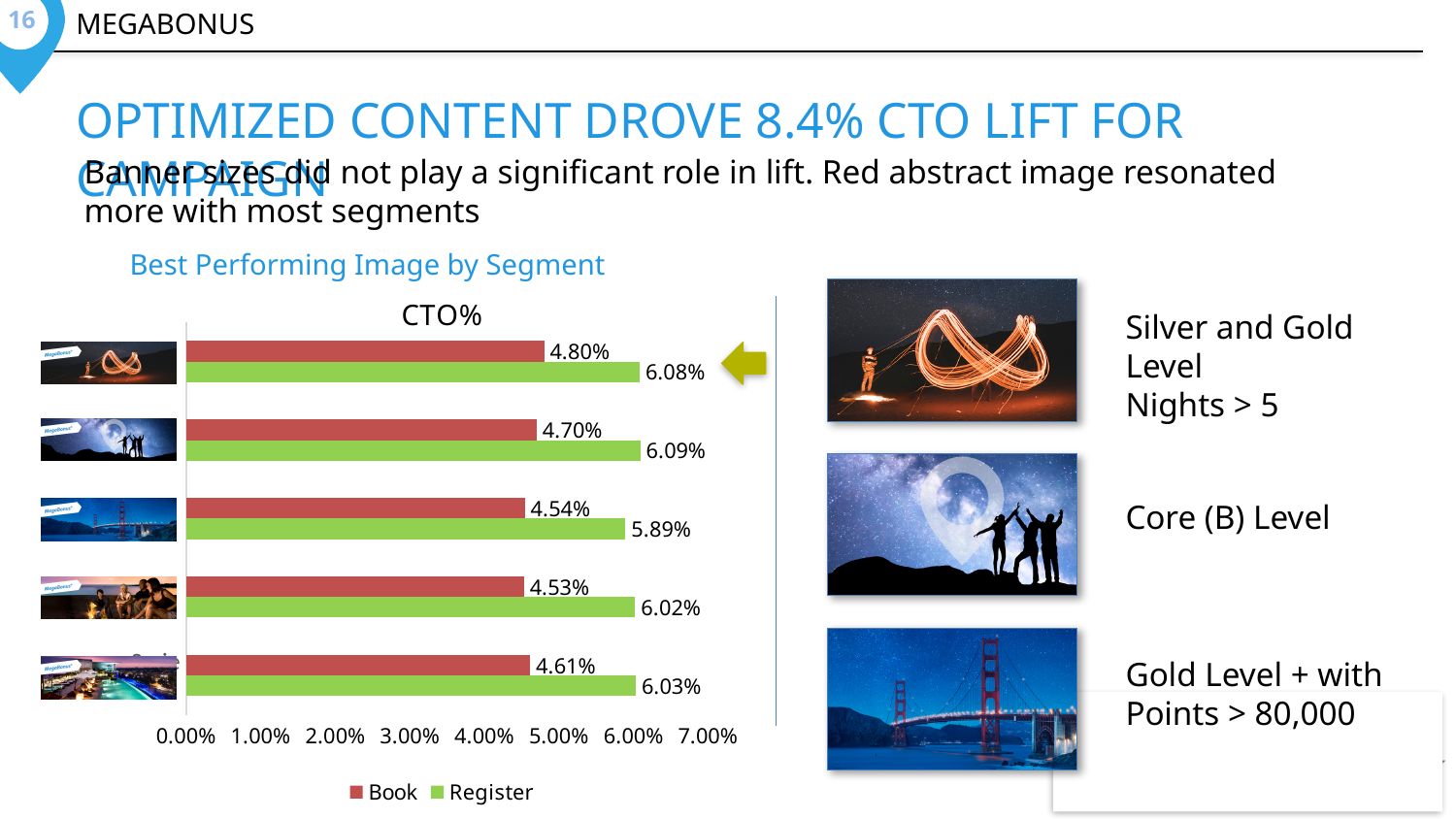
What is the Book value for the top category in the chart? 4.80% How many categories (image rows) are plotted in the chart? 5 What is the Book value for the bottom category in the chart? 4.61% For the third category from the top, is the Register value greater or less than 6.00%? less For the top category, what is the difference between the Register and Book values? 1.28% Which category has the lowest Book value? the fourth category from the top (4.53%) How many series does the chart legend list? 2 What is the Register value for the top category in the chart? 6.08% What type of chart is shown on the slide? bar chart What is the Register value for the third category from the top? 5.89% What are the two series named in the chart legend? Book and Register Which category has the highest Book value? the top category (4.80%)